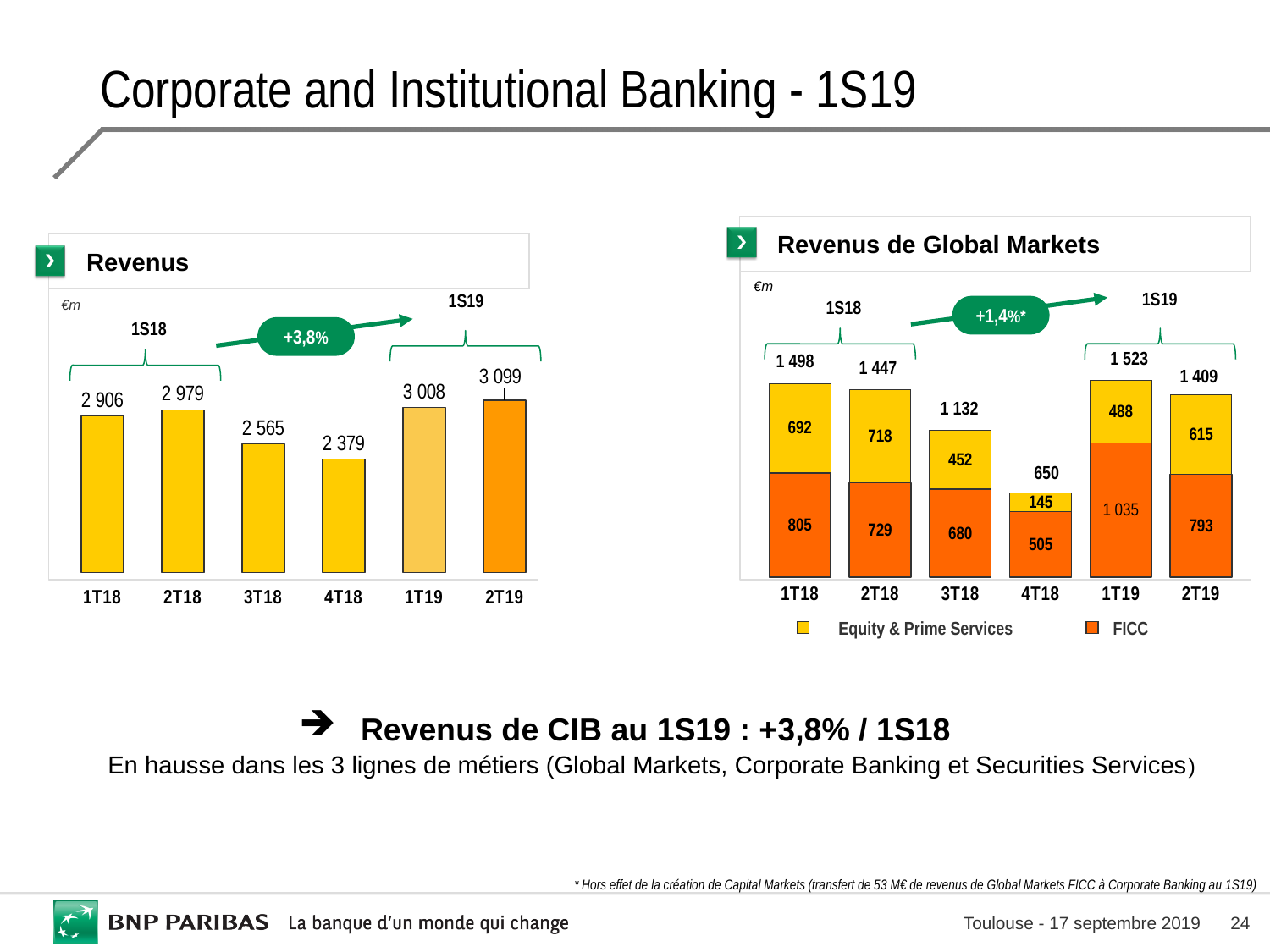
In the "Revenus de Global Markets" chart, which quarter has the lowest total revenue? 4T18 In the "Revenus de Global Markets" chart, what is the FICC value for 1T19? 1 035 In the "Revenus de Global Markets" chart, is the FICC value for 2T19 larger or smaller than the FICC value for 3T18? larger In the "Revenus" chart, what is the difference between the values for 2T19 and 1T19? 91 In the "Revenus" chart, what growth percentage is shown between 1S18 and 1S19? +3,8% In the "Revenus" chart, how many quarters are shown on the x axis? 6 How many series does the legend of the "Revenus de Global Markets" chart list? 2 In the "Revenus de Global Markets" chart, what is the Equity & Prime Services value for 4T18? 145 In the "Revenus" chart, which quarter has the lowest revenue? 4T18 In the "Revenus" chart, what is the value for 3T18? 2 565 In the "Revenus" chart, which quarter has the highest revenue? 2T19 In the "Revenus de Global Markets" chart, what is the total of the stacked bar for 2T18? 1 447